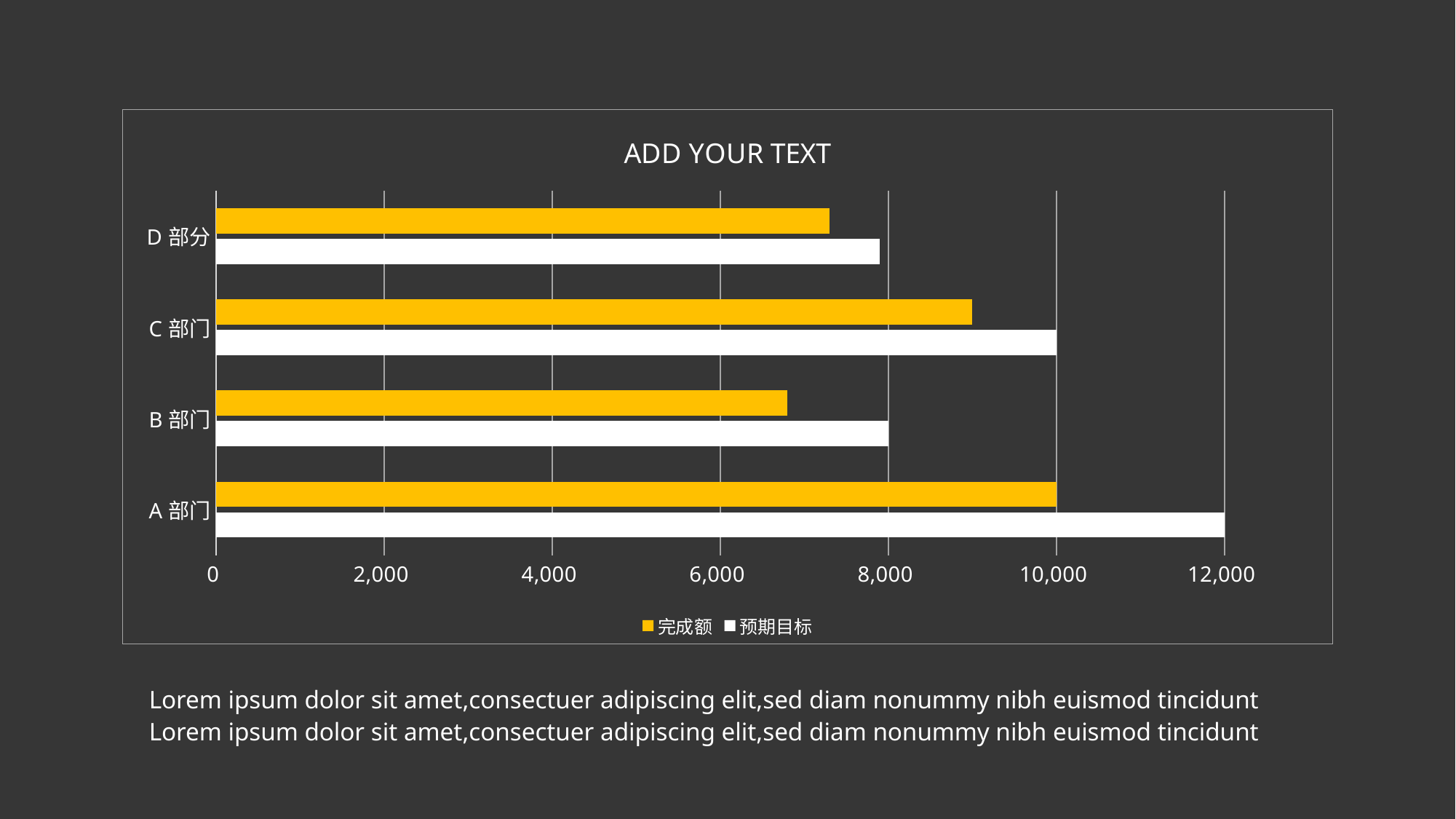
What kind of chart is shown on the slide? bar chart What is the 预期目标 value for C 部门? 10,000 What is the difference between the 预期目标 and 完成额 values for A 部门? 2,000 How many series does the legend list? 2 What is the 完成额 value for A 部门? 10,000 How many categories are shown on the chart? 4 Which category has the highest 预期目标 value? A 部门 What is the title of the chart? ADD YOUR TEXT What is the 预期目标 value for B 部门? 8,000 Is the 完成额 value for C 部门 greater or less than 8,000? greater Which category has the lowest 完成额 value? B 部门 What is the 预期目标 value for A 部门? 12,000